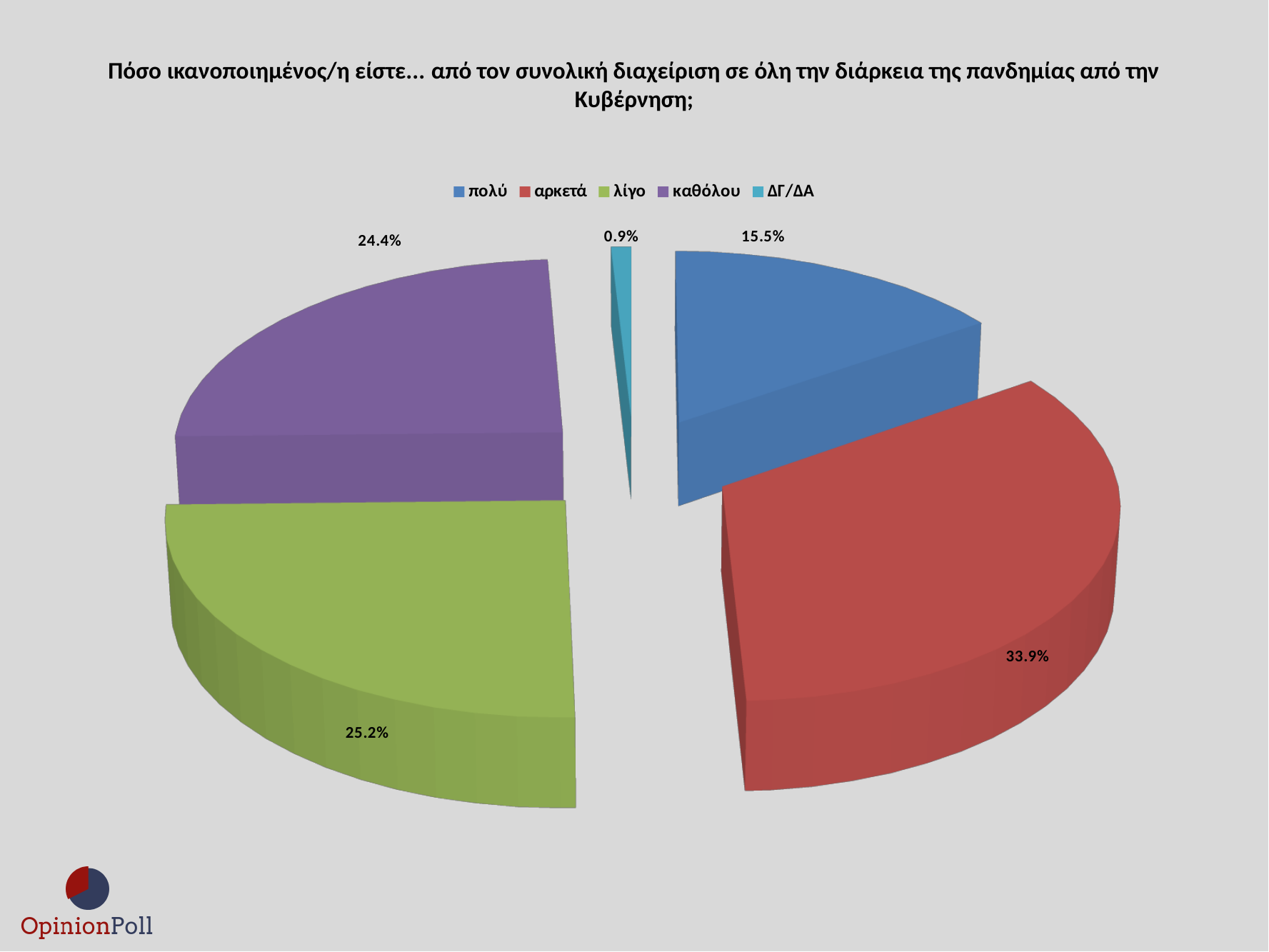
What percentage of respondents answered "καθόλου"? 24.4% Which is larger, the share for "καθόλου" or the share for "πολύ"? καθόλου What percentage of respondents answered "πολύ"? 15.5% What percentage of respondents answered "ΔΓ/ΔΑ"? 0.9% What kind of chart is shown on the slide? pie chart Which response category has the largest share of the pie? αρκετά What percentage of respondents answered "λίγο"? 25.2% How many categories does the legend list? 5 What is the difference in percentage points between "αρκετά" and "λίγο"? 8.7 What percentage of respondents answered "αρκετά"? 33.9% Which response category has the smallest share of the pie? ΔΓ/ΔΑ What is the difference in percentage points between "αρκετά" and "πολύ"? 18.4